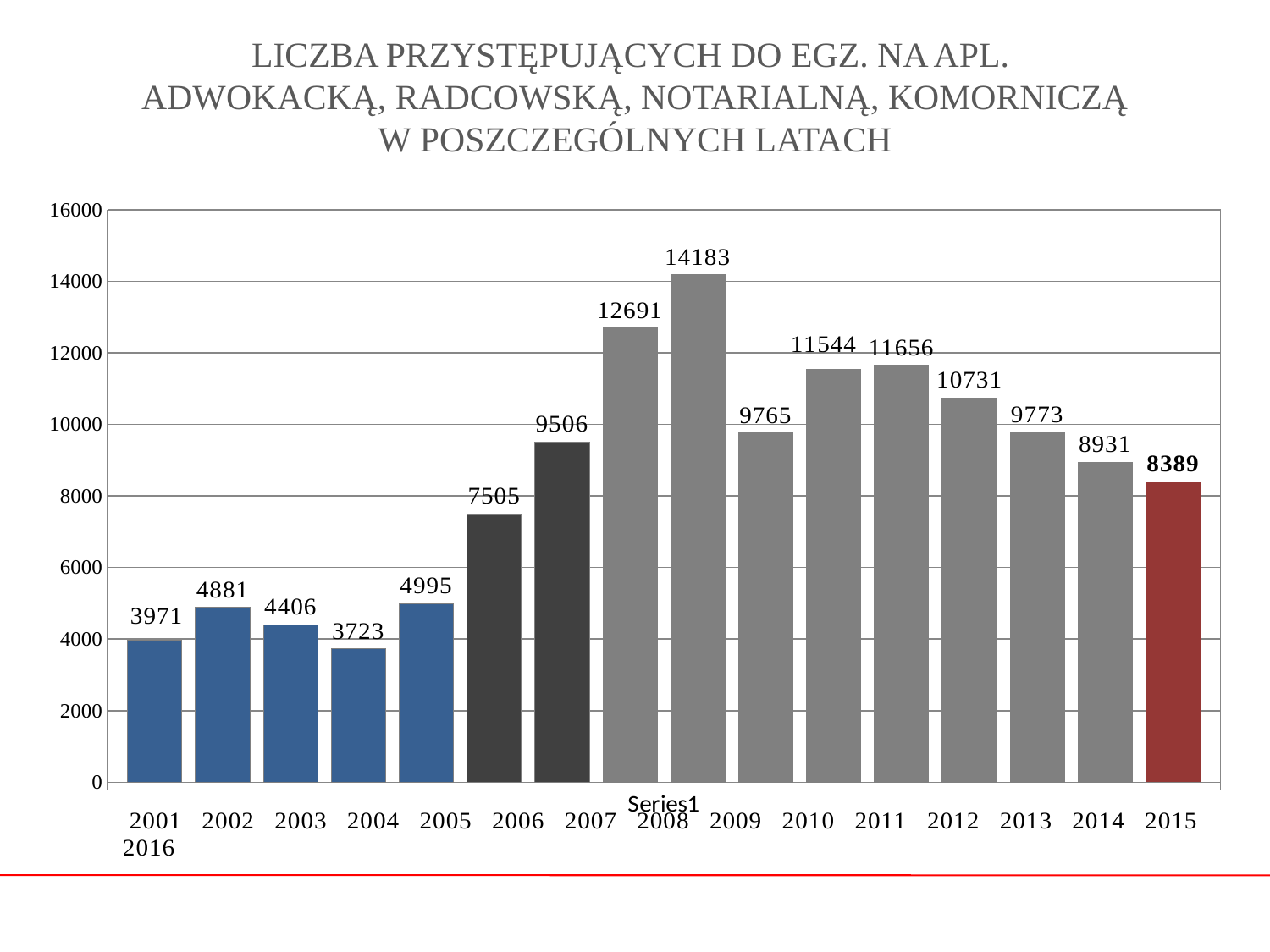
Which is larger, the bar labeled 11544 or the bar labeled 11656? 11656 What is the difference between the highest value (14183) and the lowest value (3723) in the chart? 10460 What is the value of the red bar at the right end of the chart? 8389 What is the highest value shown in the chart? 14183 How many bars are plotted in the chart? 16 What is the value of the first (leftmost) bar in the chart? 3971 Do the values rise or fall from the first bar to the tallest bar in the chart? rise How many different bar colours are used in the chart? 4 What is the lowest value shown in the chart? 3723 What kind of chart is shown on the slide? bar chart Is the value of the red bar greater or less than 10000? less What is the difference between the last two bars, 8931 and 8389? 542